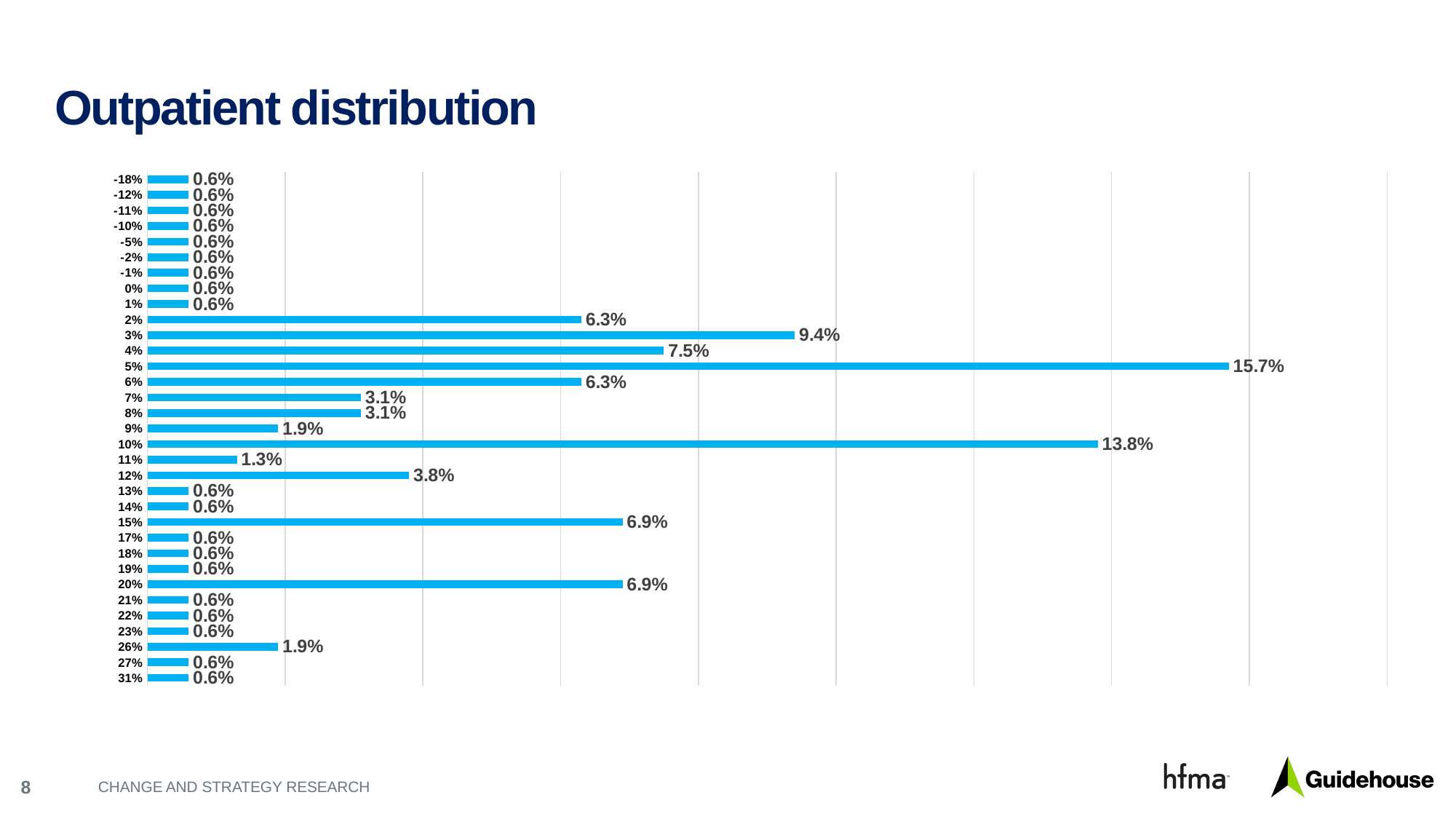
What is the difference between the values for the 3% and 4% categories? 1.9% What is the value for the 12% category? 3.8% What is the value for the 5% category? 15.7% What is the value for the 3% category? 9.4% Which is larger, the value for the 15% category or the value for the 12% category? 15% Which category has the highest value? 5% What is the difference between the values for the 5% and 10% categories? 1.9% What kind of chart is shown on the slide? Bar chart What is the title of the slide? Outpatient distribution What is the value for the 10% category? 13.8% What is the lowest value shown on the chart? 0.6% How many categories are shown on the chart? 33